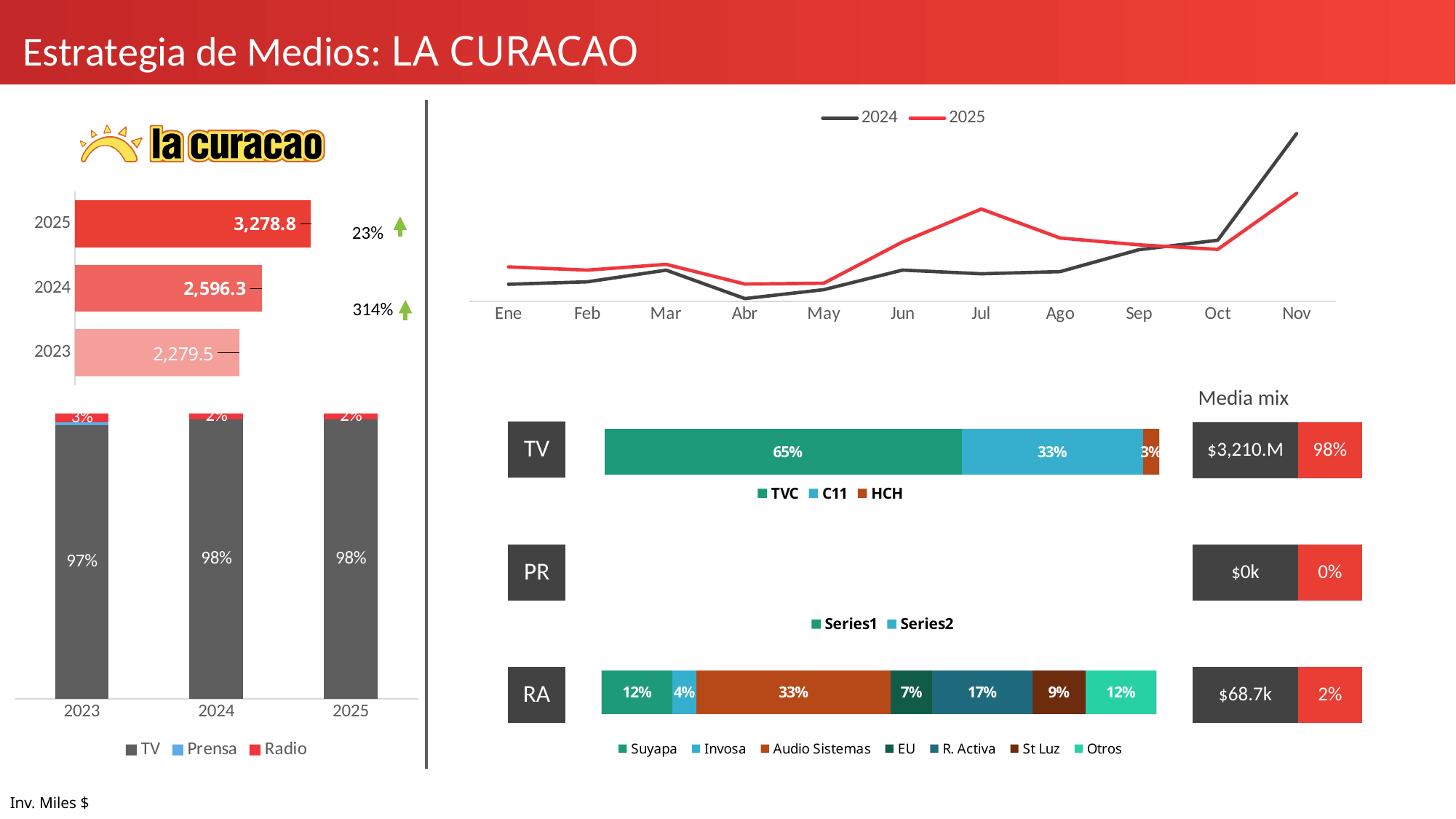
In the horizontal bar chart on the left, what is the value for 2023? 2,279.5 In the horizontal bar chart on the left, what is the difference between the 2025 and 2024 values? 682.5 In the TV stacked bar, what is the share for C11? 33% In the RA stacked bar, what is the difference between the R. Activa and St Luz shares? 8% In the RA stacked bar, which category has the largest share? Audio Sistemas In the horizontal bar chart on the left, which year has the lowest value? 2023 In the horizontal bar chart on the left, what is the value for 2025? 3,278.8 In the line chart at the top right, which month has the highest value for the 2024 series? Nov In the line chart at the top right, which series is higher in Jul, 2024 or 2025? 2025 In the stacked bar chart at the bottom left, how many series does the legend list? 3 In the line chart at the top right, how many months are shown on the x axis? 11 In the stacked bar chart at the bottom left, what share does TV have in 2023? 97%